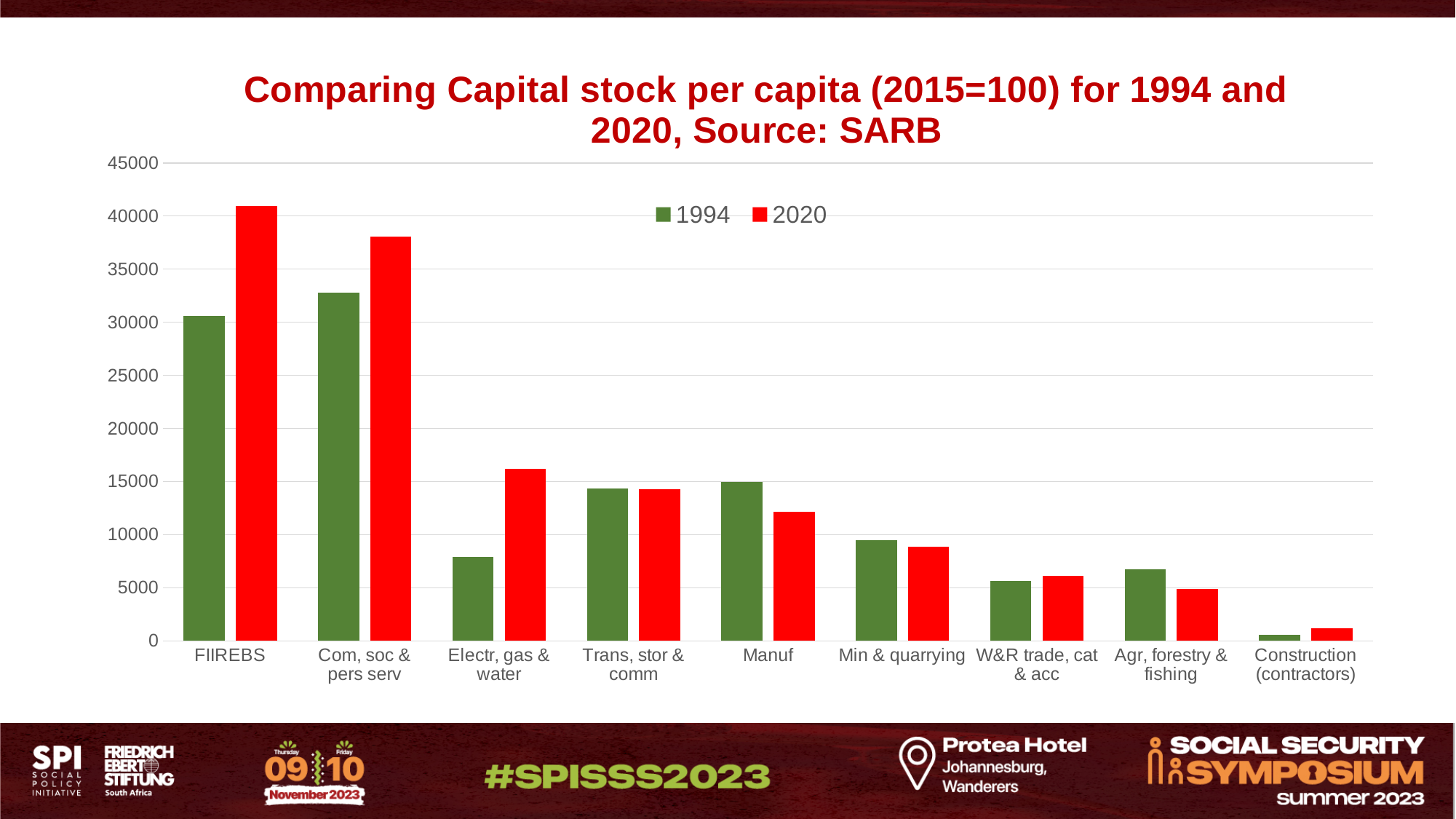
How many sectors (categories) are shown on the x axis? 9 Which sector has the highest capital stock per capita for 2020? FIIREBS How many series does the legend list? 2 Is the 2020 value for FIIREBS greater or less than 35000? greater What kind of chart is shown on the slide? bar chart For Manuf, which year has the larger value, 1994 or 2020? 1994 For Agr, forestry & fishing, which year has the larger value, 1994 or 2020? 1994 Is the 1994 value for Electr, gas & water greater or less than 10000? less Which sector has the highest capital stock per capita for 1994? Com, soc & pers serv Which sector has the lowest capital stock per capita for 2020? Construction (contractors) Which sector has the lowest capital stock per capita for 1994? Construction (contractors) What colour represents the 2020 series in the legend? red